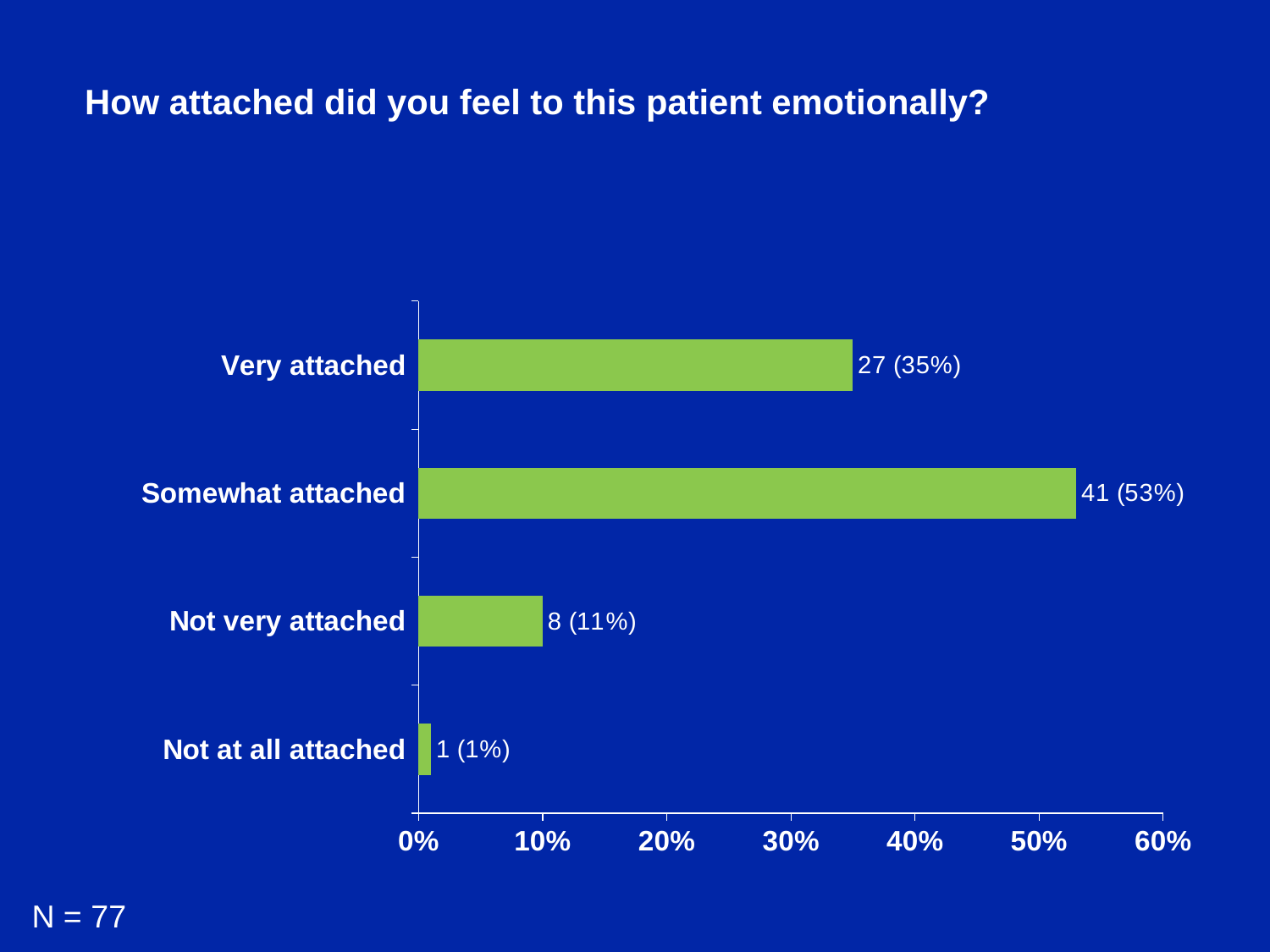
How many categories are shown in the chart? 4 What is the difference in count between "Somewhat attached" and "Very attached"? 14 What is the data label for "Not very attached"? 8 (11%) What is the data label for "Very attached"? 27 (35%) What kind of chart is shown on the slide? Bar chart Is the value for "Somewhat attached" greater or less than 50%? greater What is the data label for "Somewhat attached"? 41 (53%) Which category has the lowest value? Not at all attached Which category has the highest value? Somewhat attached Which is larger, the value for "Very attached" or "Not very attached"? Very attached What is the title of the chart? How attached did you feel to this patient emotionally? What is the data label for "Not at all attached"? 1 (1%)